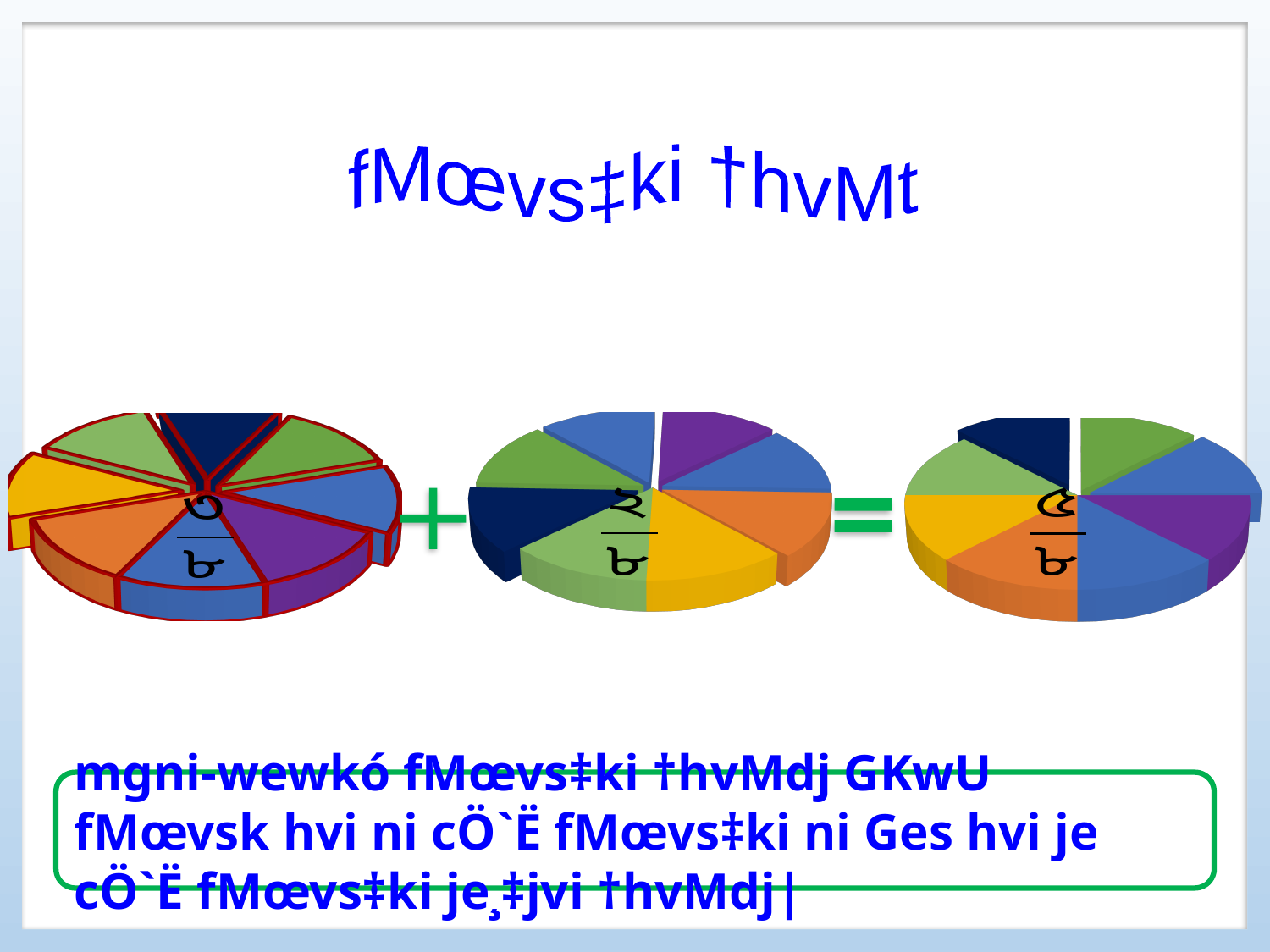
What symbol appears between the left and middle pie charts? + How many slices does the left pie chart have? 8 What fraction is printed on the left pie chart? ৩/৮ How many slices does the middle pie chart have? 8 How many slices does the right pie chart have? 8 What fraction is printed on the middle pie chart? ২/৮ What symbol appears between the middle and right pie charts? = What kind of chart is the right chart on the slide? pie chart What kind of chart is the left chart on the slide? pie chart What fraction is printed on the right pie chart? ৫/৮